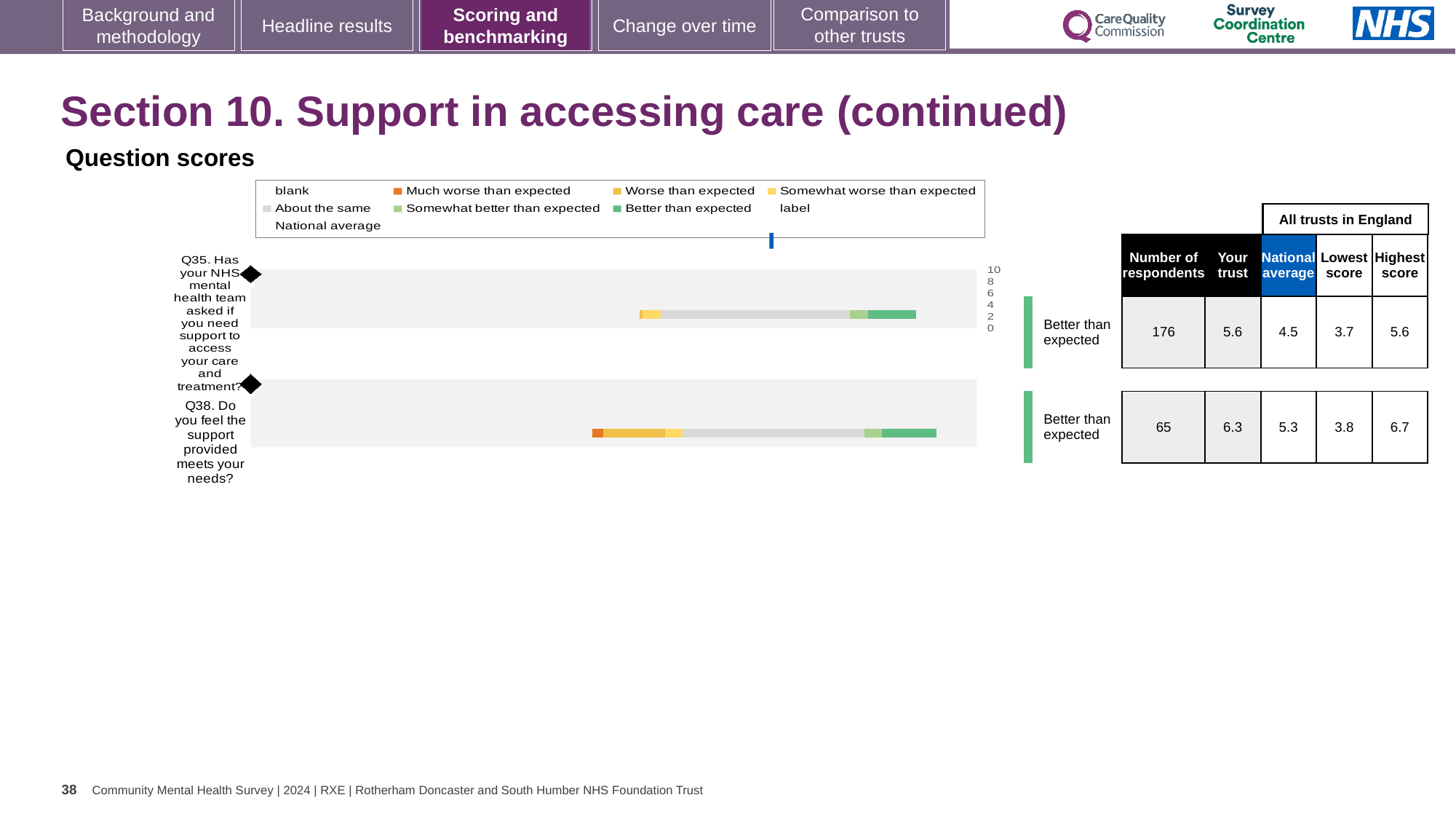
What benchmark category is shown next to the bar for Q35? Better than expected What kind of chart is used to show the question scores on this slide? bar chart What is the difference between the highest score and the lowest score for Q35? 1.9 What is the difference between the 'Your trust' score and the national average for Q38? 1.0 How many questions are plotted in the question scores chart? 2 What benchmark category is shown next to the bar for Q38? Better than expected What is the highest score among all trusts in England for Q38? 6.7 What is the national average score for Q35? 4.5 How many respondents answered Q38? 65 What is the 'Your trust' score for Q35 in the table beside the chart? 5.6 Which question had more respondents, Q35 or Q38? Q35 What is the 'Your trust' score for Q38 in the table beside the chart? 6.3